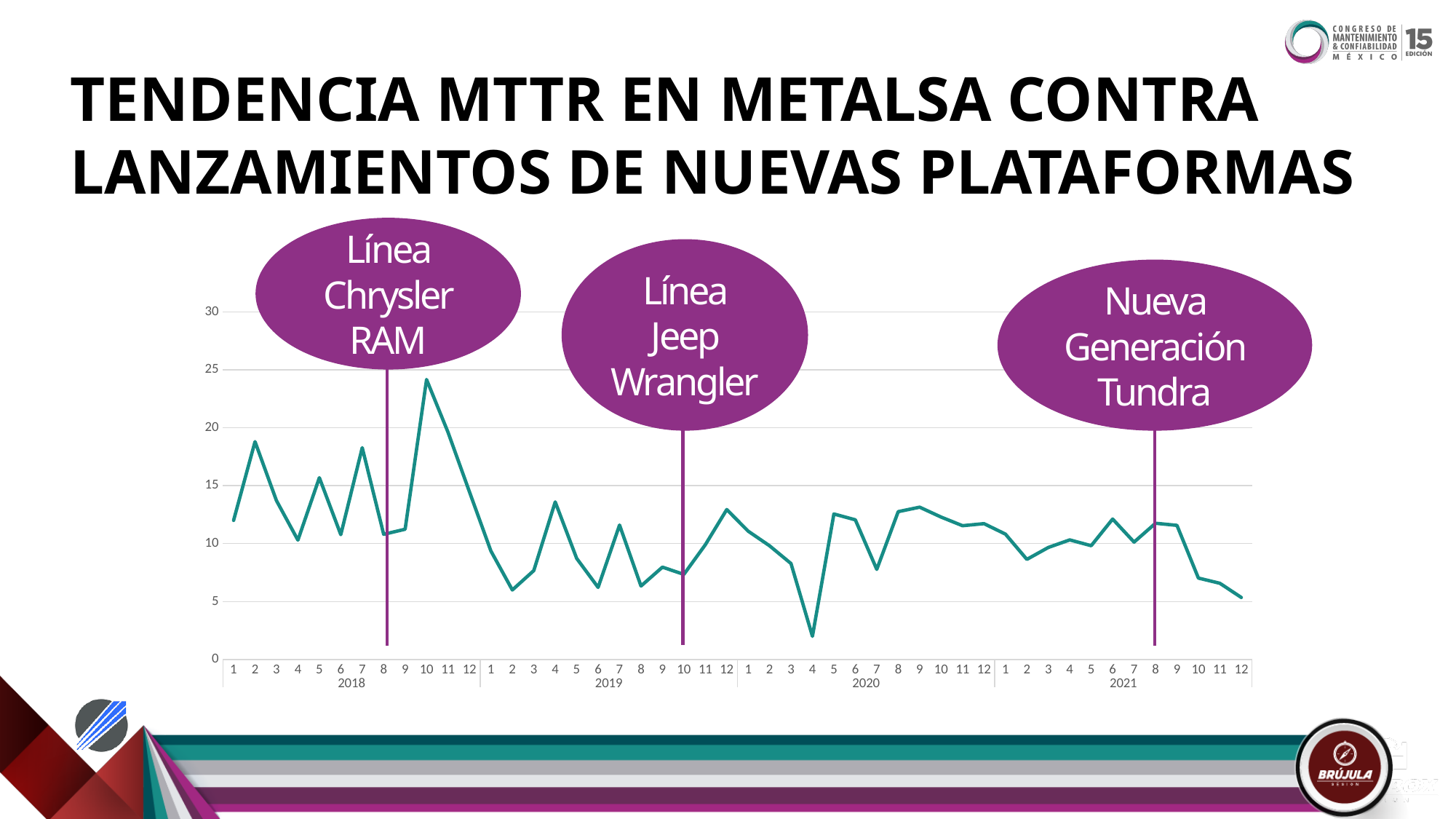
Is the value for month 12 of 2021 greater or less than 10? less Is the value for month 2 of 2019 greater or less than 10? less Which month and year has the highest MTTR value on the chart? Month 10 of 2018 What kind of chart is shown on the slide? line chart How many years are shown along the x axis of the chart? 4 Do the values rise or fall from month 8 to month 12 of 2021? fall Is the value for month 10 of 2018 greater or less than 20? greater Which month and year has the lowest MTTR value on the chart? Month 4 of 2020 What platform launch is marked by the callout at month 10 of 2019? Línea Jeep Wrangler Which is larger, the value for month 10 of 2018 or the value for month 4 of 2019? Month 10 of 2018